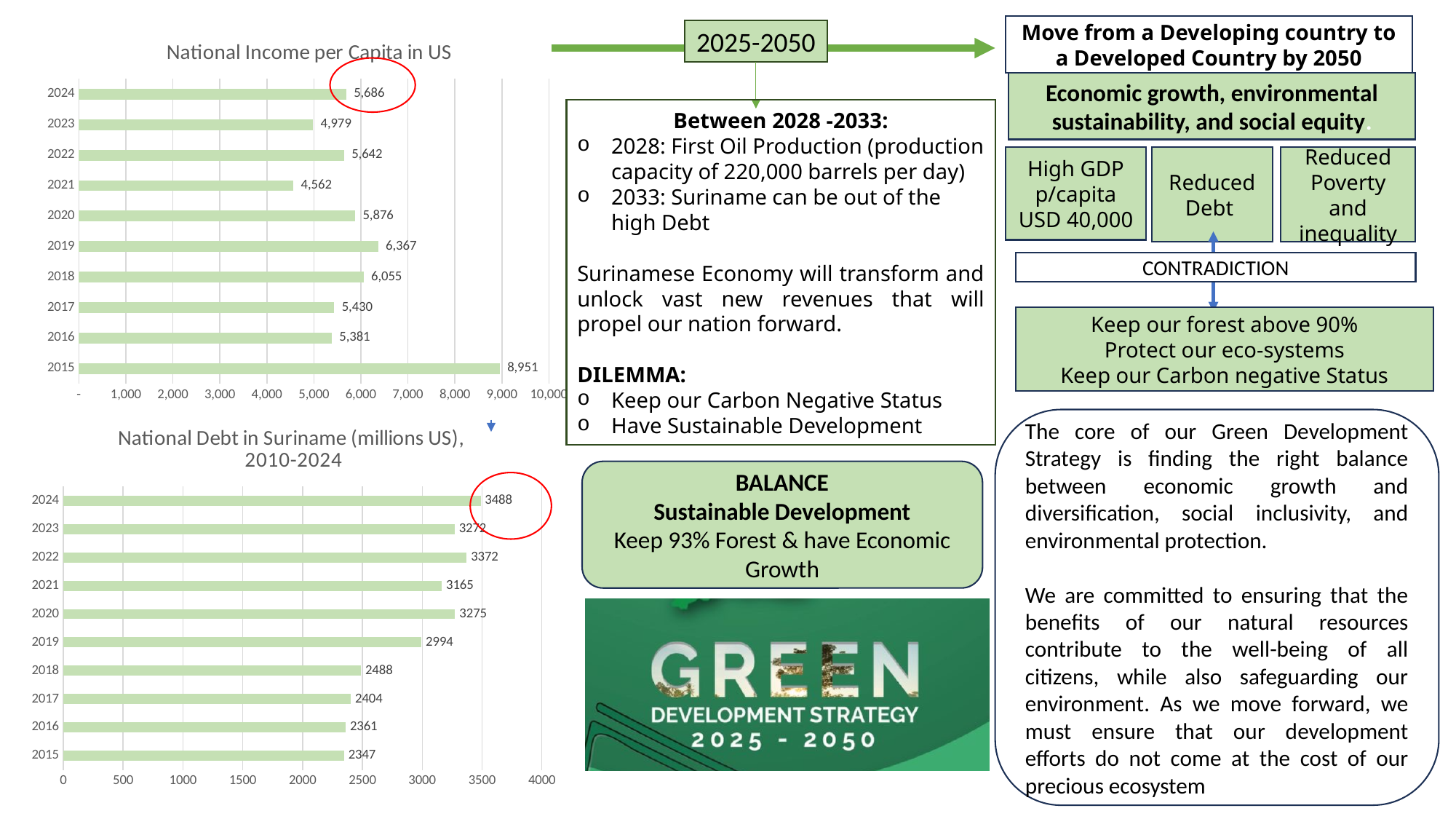
What type of chart is the 'National Income per Capita in US' chart? Bar chart In the 'National Income per Capita in US' chart, which year has the lowest value? 2021 In the 'National Debt in Suriname (millions US), 2010-2024' chart, do the values generally rise or fall from 2015 to 2024? Rise In the 'National Income per Capita in US' chart, what is the difference between the values for 2019 and 2018? 312 In the 'National Debt in Suriname (millions US), 2010-2024' chart, which is larger, the value for 2022 or the value for 2020? 2022 In the 'National Debt in Suriname (millions US), 2010-2024' chart, which year has the lowest value? 2015 In the 'National Debt in Suriname (millions US), 2010-2024' chart, what is the difference between the values for 2024 and 2023? 216 In the 'National Income per Capita in US' chart, which year has the highest value? 2015 In the 'National Debt in Suriname (millions US), 2010-2024' chart, what is the value for 2019? 2994 In the 'National Income per Capita in US' chart, what is the value for 2024? 5,686 In the 'National Income per Capita in US' chart, how many years are shown? 10 In the 'National Debt in Suriname (millions US), 2010-2024' chart, which year has the highest value? 2024